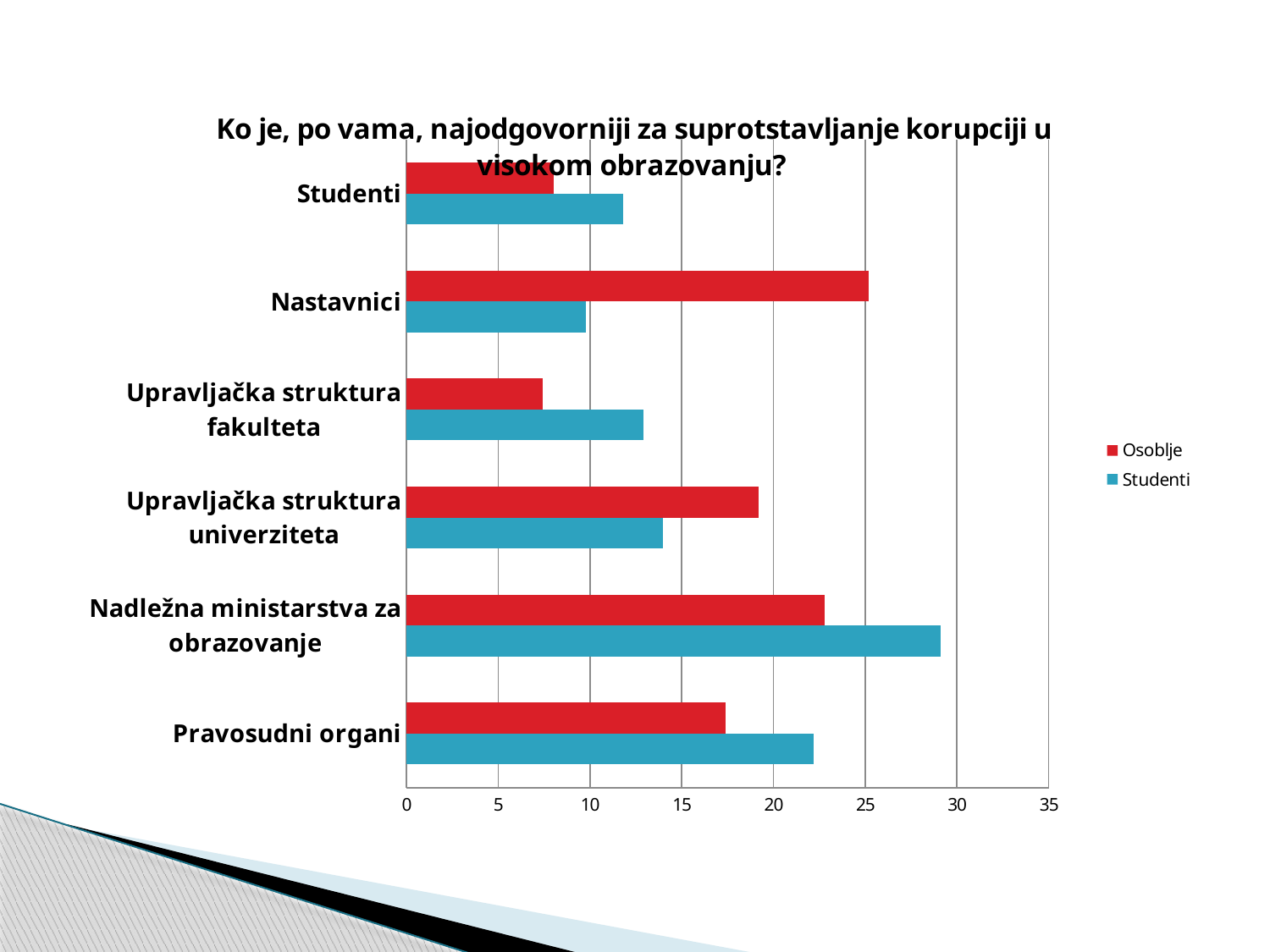
What kind of chart is shown on the slide? bar chart Which category has the highest value for the Studenti series? Nadležna ministarstva za obrazovanje Which category has the lowest value for the Studenti series? Nastavnici How many series does the legend list? 2 Which category has the lowest value for the Osoblje series? Upravljačka struktura fakulteta Which colour represents the Osoblje series in the legend? red How many categories are shown on the chart? 6 Is the Studenti value for Upravljačka struktura univerziteta greater or less than 15? less Which category has the highest value for the Osoblje series? Nastavnici For Pravosudni organi, which series has the larger value, Osoblje or Studenti? Studenti For Nastavnici, which series has the larger value, Osoblje or Studenti? Osoblje